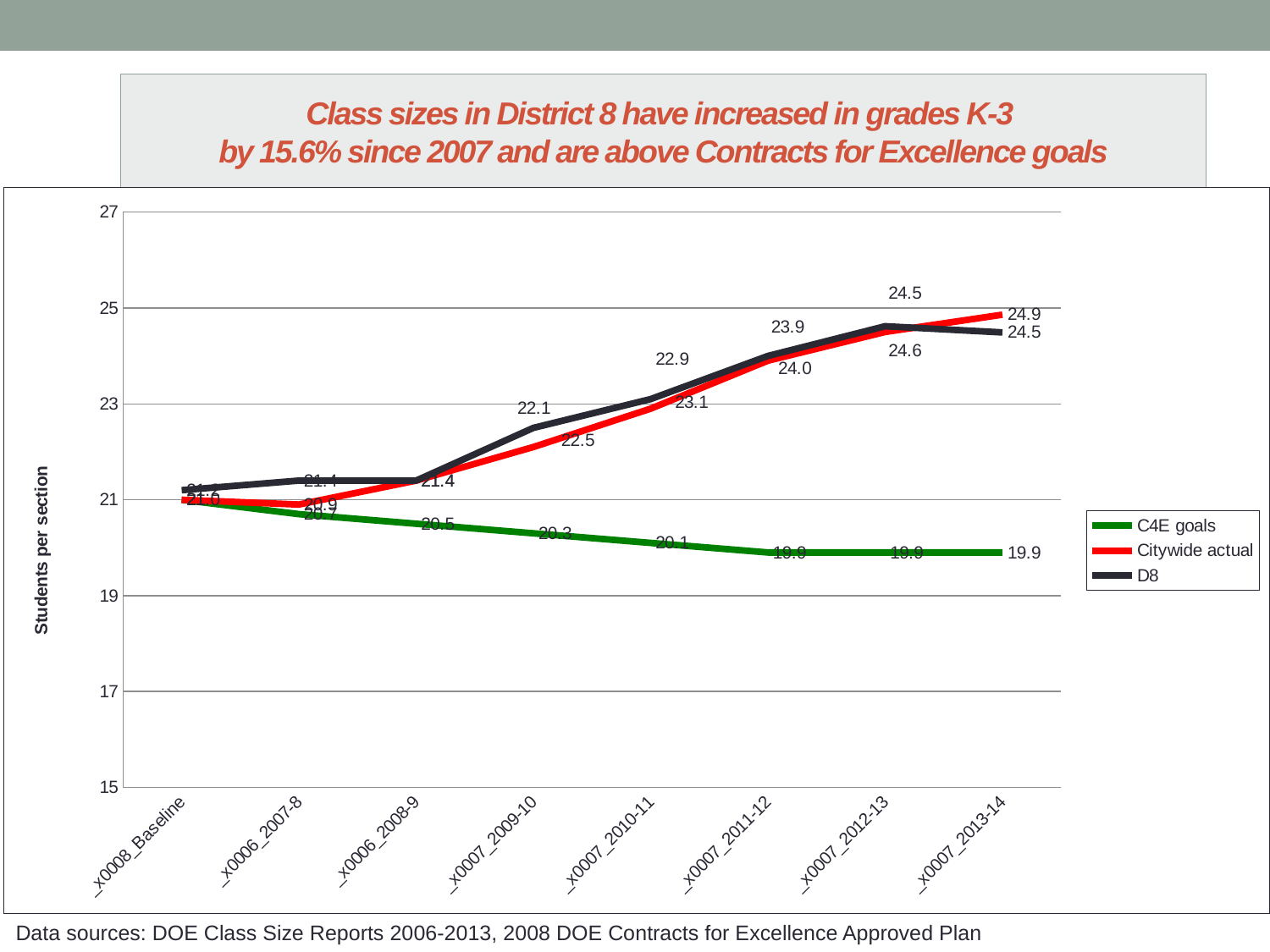
What is the label on the vertical axis? Students per section How many categories are shown along the x axis? 8 How many series does the legend list? 3 What is the C4E goals value for 2013-14? 19.9 Is the D8 value for 2009-10 greater or less than 23? less What is the difference between the Citywide actual and C4E goals values in 2013-14? 5.0 What kind of chart is shown on the slide? line chart Do the C4E goals values rise or fall along the x axis? fall What is the Citywide actual value for 2013-14? 24.9 What is the D8 value for 2009-10? 22.5 What is the D8 value for 2012-13? 24.6 Which series has the higher value in 2011-12, Citywide actual or D8? D8